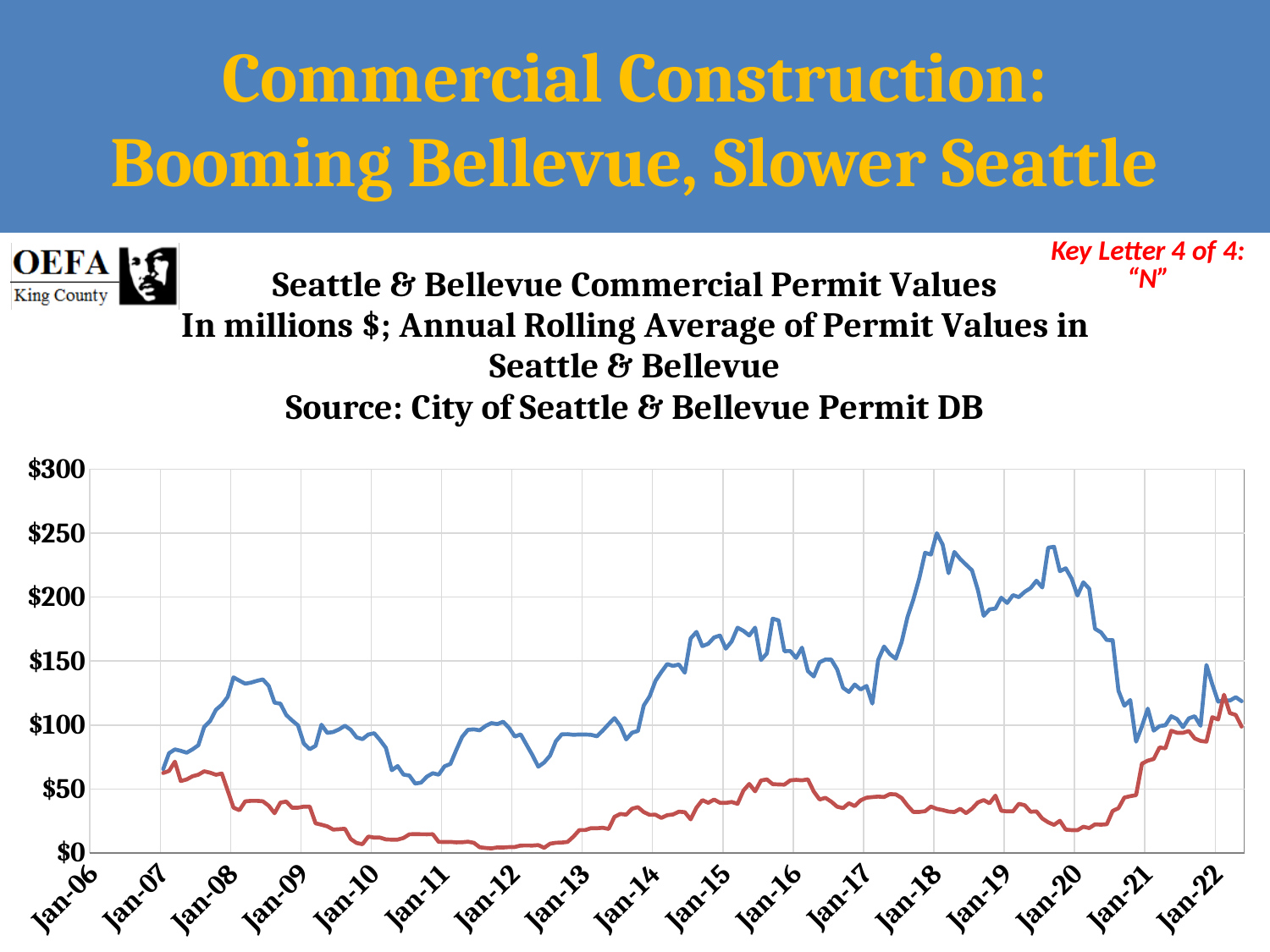
Is the value of the blue line at Jan-11 greater or less than $100? less What kind of chart is shown on the slide? line chart Is the value of the red line at Jan-12 greater or less than $50? less What is the last label shown on the x axis? Jan-22 Is the value of the blue line at Jan-18 greater or less than $200? greater What is the highest value shown on the y axis? $300 Does the blue line rise or fall between Jan-20 and Jan-21? fall At Jan-15, which line is higher, the blue line or the red line? the blue line How many lines are plotted on the chart? 2 Does the red line rise or fall between Jan-20 and Jan-22? rise